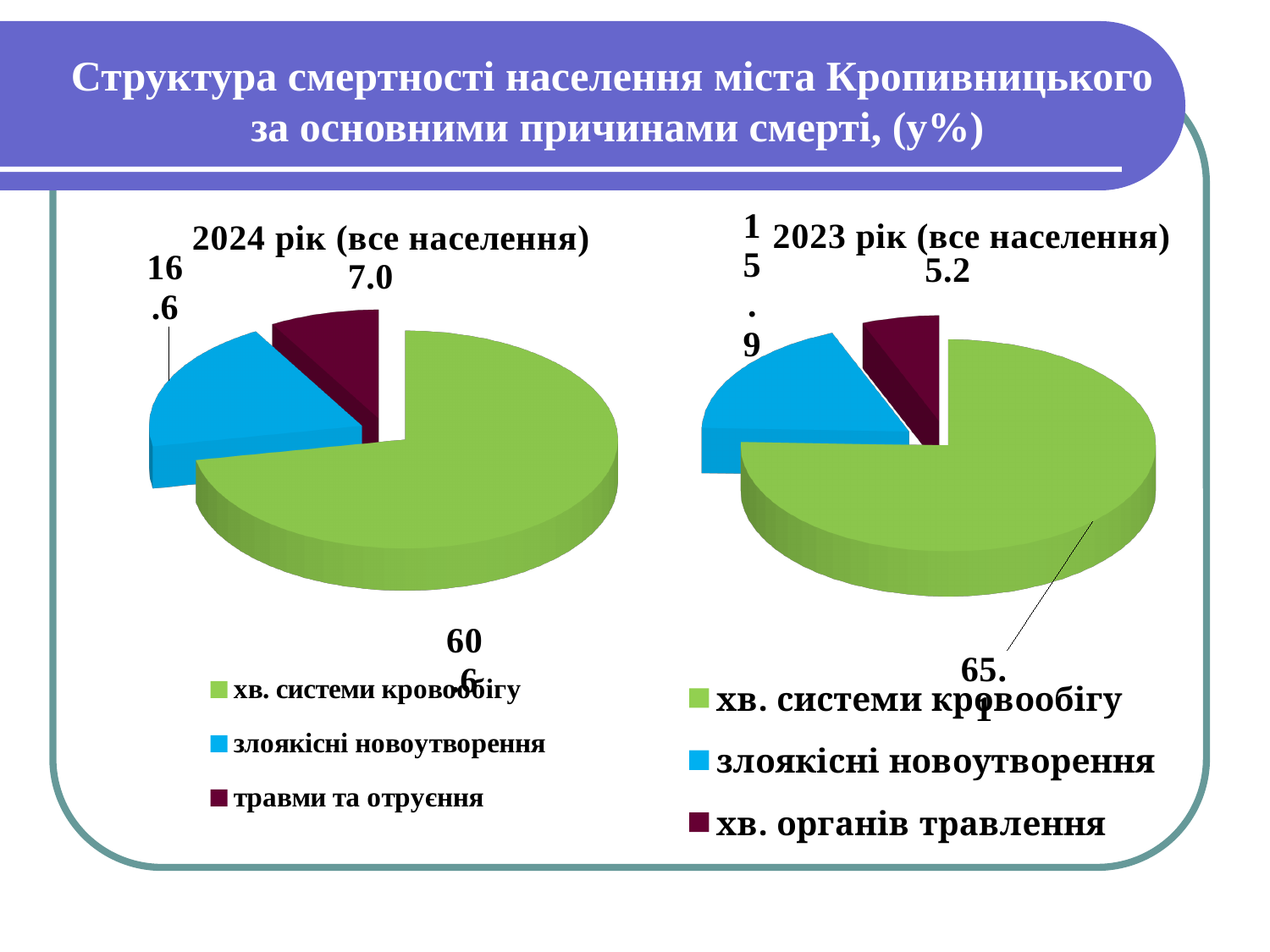
In the "2024 рік (все населення)" chart, which category has the largest slice? хв. системи кровообігу In the "2023 рік (все населення)" chart, what is the difference between злоякісні новоутворення and хв. органів травлення? 10.7 In the "2024 рік (все населення)" chart, what is the value for травми та отруєння? 7.0 In the "2023 рік (все населення)" chart, which category has the smallest slice? хв. органів травлення In the "2023 рік (все населення)" chart, what is the value for хв. органів травлення? 5.2 In the "2023 рік (все населення)" chart, what is the value for хв. системи кровообігу? 65.1 How many slices does the "2023 рік (все населення)" pie chart have? 3 What kind of chart is the "2024 рік (все населення)" chart? pie chart In the "2024 рік (все населення)" chart, what is the difference between злоякісні новоутворення and травми та отруєння? 9.6 In the "2024 рік (все населення)" chart, which category is shown in dark red? травми та отруєння In the "2024 рік (все населення)" chart, what is the value for злоякісні новоутворення? 16.6 In the "2023 рік (все населення)" chart, what is the value for злоякісні новоутворення? 15.9